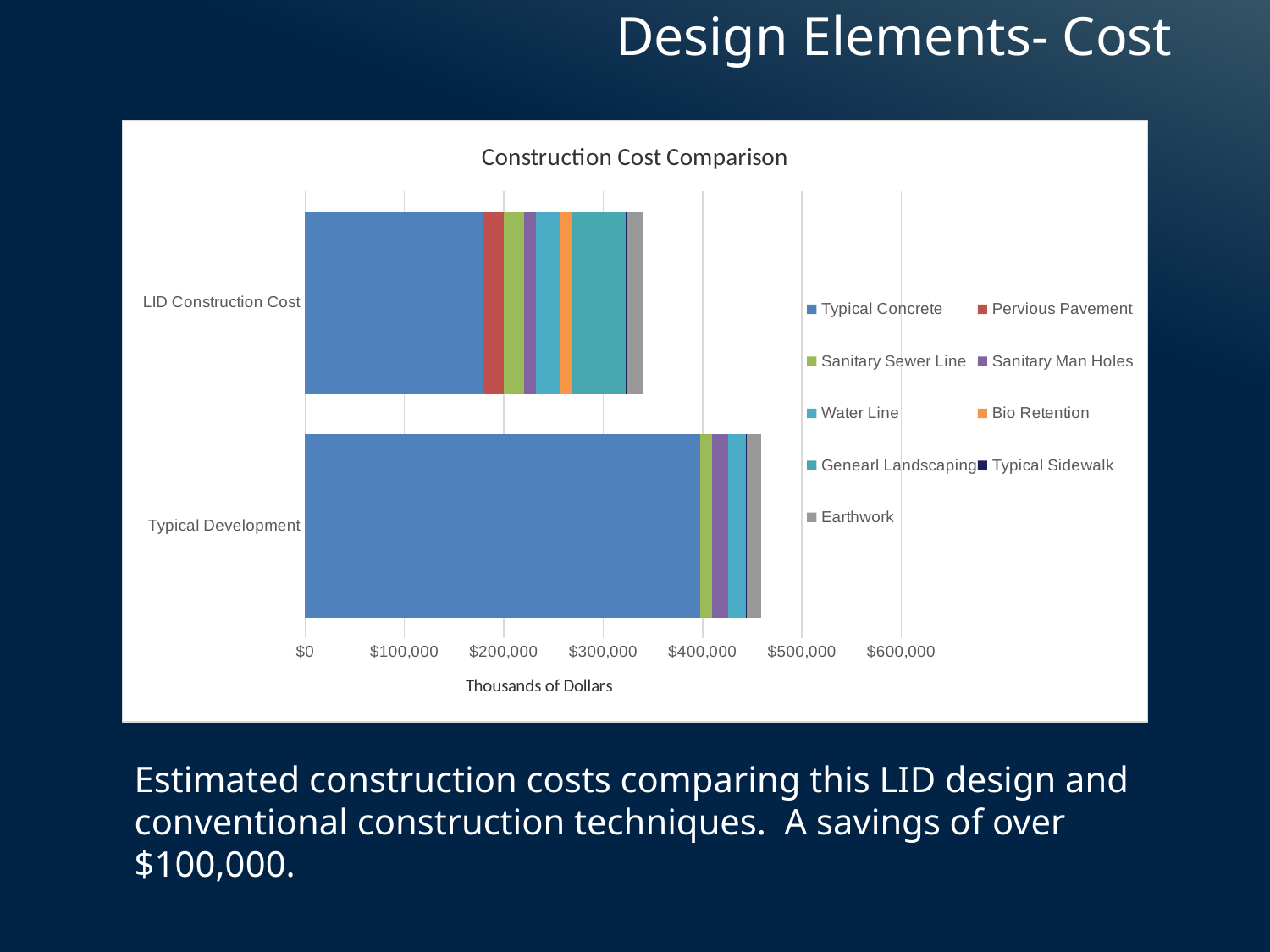
How many series does the chart legend list? 9 How many categories (bars) are plotted in the chart? 2 Is the Typical Concrete value for LID Construction Cost greater or less than $200,000? less Is the total value for LID Construction Cost greater or less than $300,000? greater What type of chart is shown on the slide? Stacked bar chart Is the total value for Typical Development greater or less than $500,000? less Which category has the larger Typical Concrete segment, LID Construction Cost or Typical Development? Typical Development What is the label on the horizontal axis of the chart? Thousands of Dollars Which category has the larger total construction cost, LID Construction Cost or Typical Development? Typical Development What is the title of the chart? Construction Cost Comparison Which category has the lowest total construction cost? LID Construction Cost